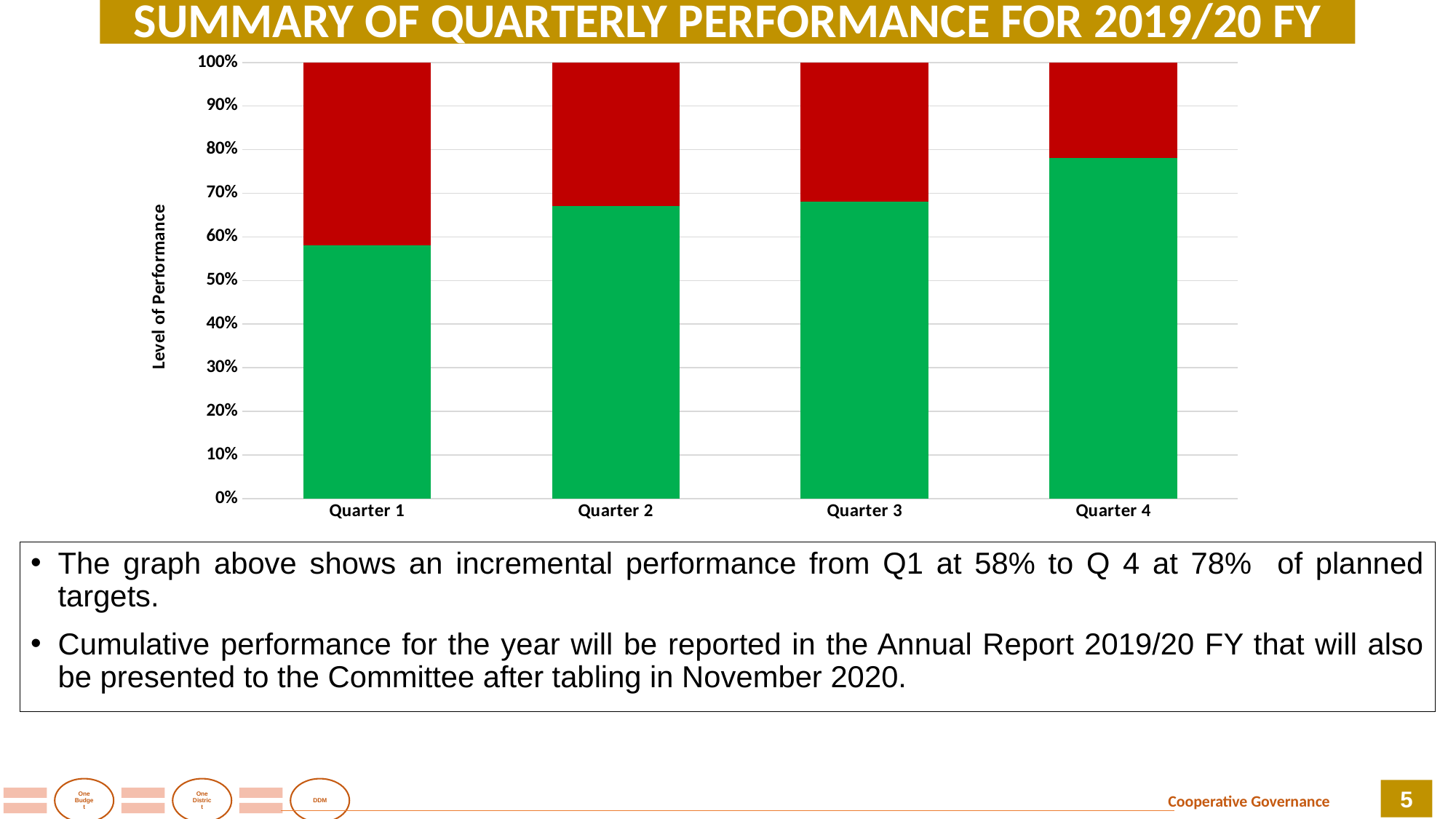
What is the level of performance (green segment) for Quarter 4? 78% Does the green (performance) segment rise or fall from Quarter 1 to Quarter 4? Rises What type of chart is shown on the slide? Stacked bar chart Which quarter has the highest green (performance) segment? Quarter 4 By how many percentage points does the Quarter 4 performance exceed the Quarter 1 performance? 20 percentage points What is the title shown above the chart? SUMMARY OF QUARTERLY PERFORMANCE FOR 2019/20 FY Is the green segment for Quarter 2 greater or less than 60%? greater Which quarter has the lowest green (performance) segment? Quarter 1 What is the level of performance (green segment) for Quarter 1? 58% Is the green segment for Quarter 3 greater or less than 70%? less What is the title of the chart's vertical axis? Level of Performance How many quarters are shown on the x axis of the chart? 4